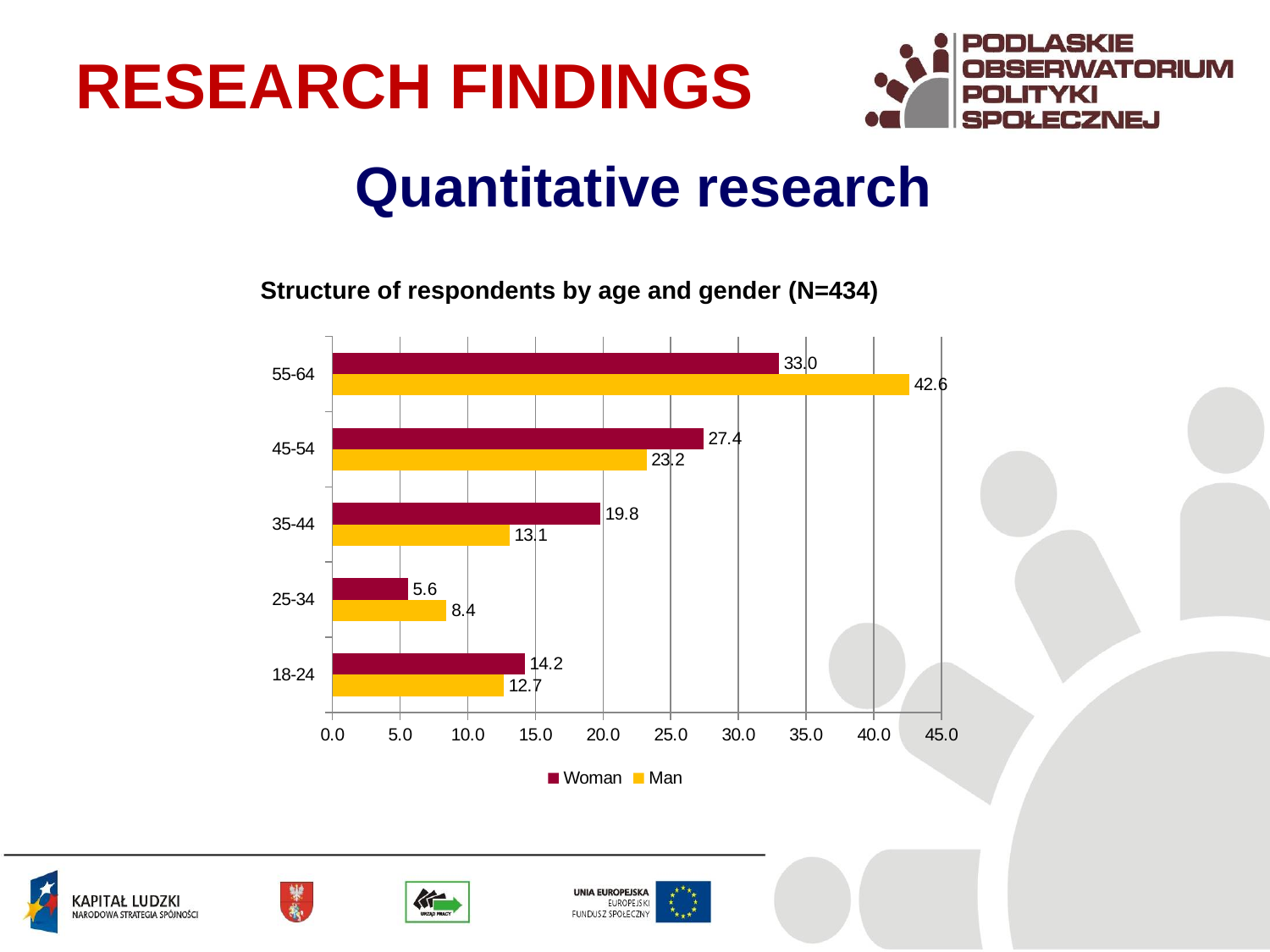
What is the value for Man in the 25-34 age group? 8.4 What is the title of the chart? Structure of respondents by age and gender (N=434) Which age group has the lowest value for Woman? 25-34 What is the value for Man in the 35-44 age group? 13.1 What is the difference between the Man and Woman values in the 55-64 age group? 9.6 What is the value for Woman in the 55-64 age group? 33.0 What kind of chart is shown on the slide? bar chart Which age group has the highest value for Man? 55-64 How many series does the legend list? 2 In the 45-54 age group, which is larger, the Woman value or the Man value? Woman How many age groups are shown on the chart? 5 Is the value for Man in the 55-64 age group greater or less than 40.0? greater